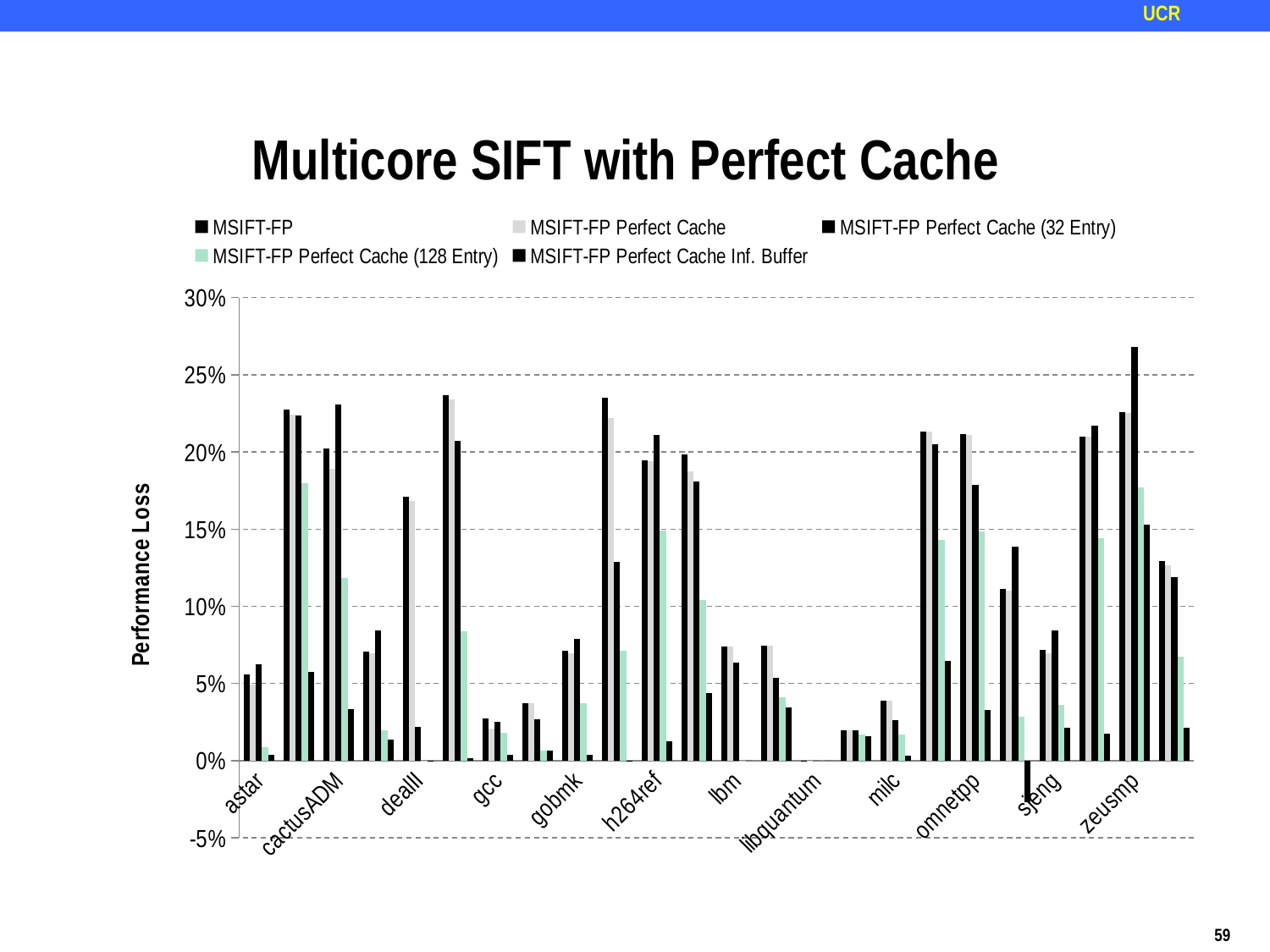
Is the MSIFT-FP value for astar greater or less than 0%? greater What is the highest value shown on the vertical axis? 30% What kind of chart is shown on the slide? bar chart What is the label on the vertical axis? Performance Loss What is the title of the chart? Multicore SIFT with Perfect Cache Is the tallest bar in the chart greater or less than 25%? greater Is the MSIFT-FP value for astar greater or less than the MSIFT-FP value for zeusmp? less Which category contains the tallest bar in the chart? zeusmp How many series does the legend list? 5 Is the MSIFT-FP value for astar greater or less than 10%? less